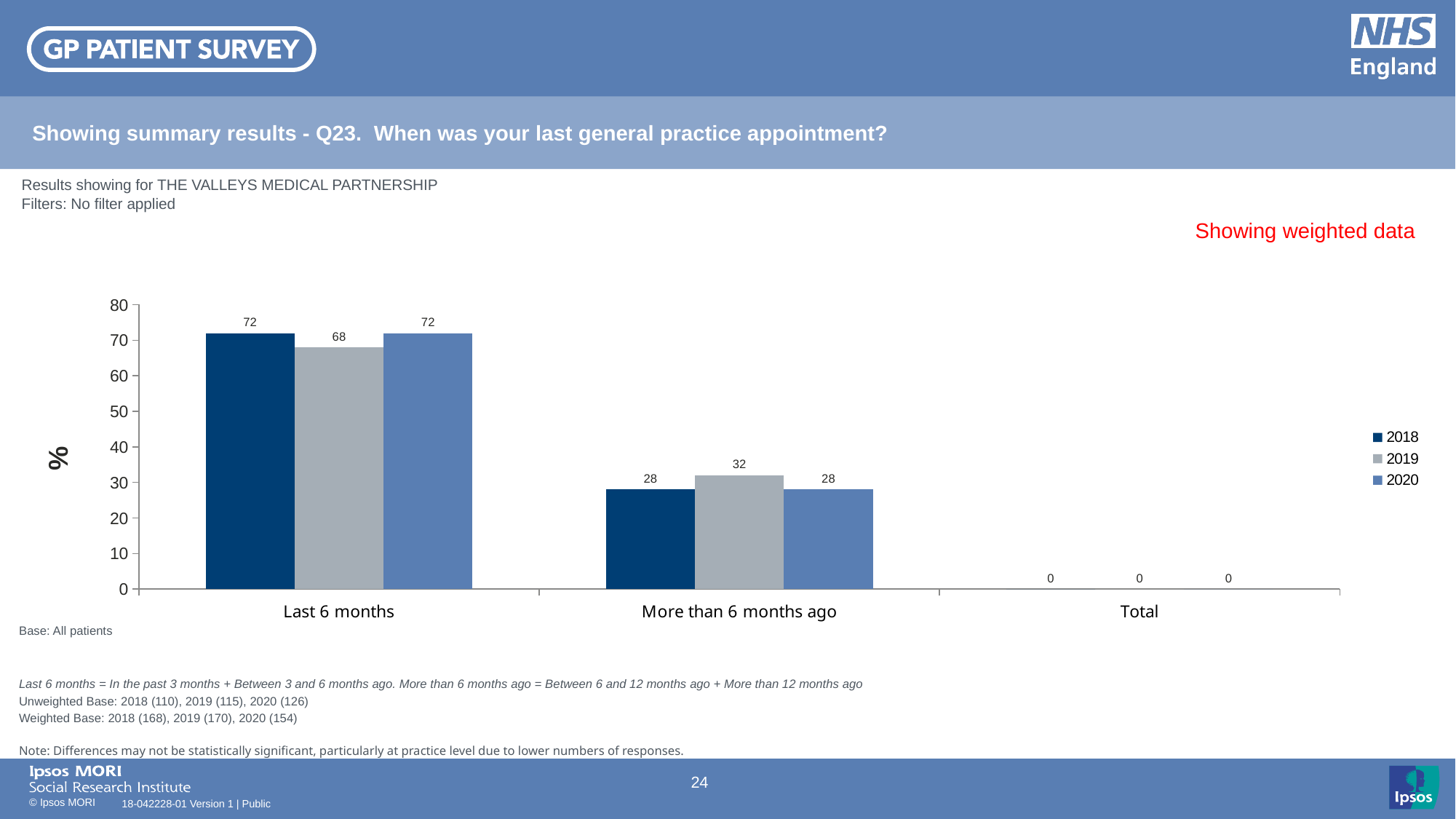
Which year has the highest value in the 'More than 6 months ago' category? 2019 What is the value for 2018 in the 'Last 6 months' category? 72 What is the value for 2020 in the 'More than 6 months ago' category? 28 What is the label on the y axis? % What kind of chart is shown on the slide? Bar chart How many series does the legend list? 3 What is the difference between the 2018 and 2019 values in the 'Last 6 months' category? 4 What is the difference between the 2019 and 2020 values in the 'More than 6 months ago' category? 4 What is the value for 2019 in the 'Last 6 months' category? 68 Which is larger: the 2019 value for 'Last 6 months' or the 2019 value for 'More than 6 months ago'? Last 6 months Which year has the lowest value in the 'Last 6 months' category? 2019 How many categories are shown on the x axis? 3